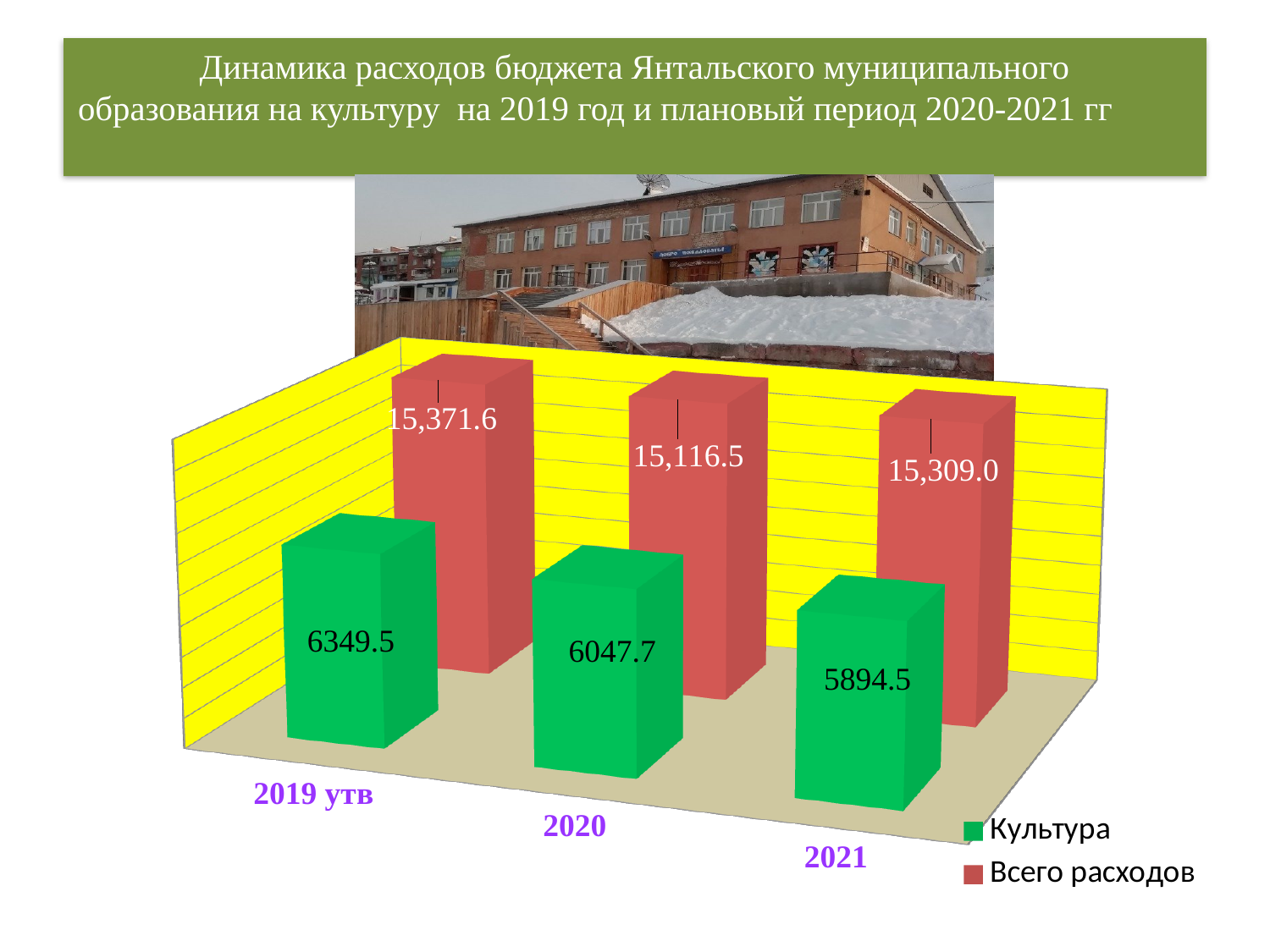
How many years (categories) are shown on the x axis? 3 What is the value for Всего расходов in 2021? 15,309.0 What is the difference between Всего расходов and Культура in 2019 утв? 9022.1 What is the value for Всего расходов in 2020? 15,116.5 Do the Культура values rise or fall from 2019 утв to 2021? fall Which is larger: Культура in 2020 or Культура in 2021? Культура in 2020 By how much does the Культура value in 2019 утв exceed the Культура value in 2021? 455.0 In which year is the Культура value lowest? 2021 What is the value for Культура in 2019 утв? 6349.5 In which year is the Всего расходов value highest? 2019 утв What is the value for Культура in 2021? 5894.5 How many series does the legend list? 2